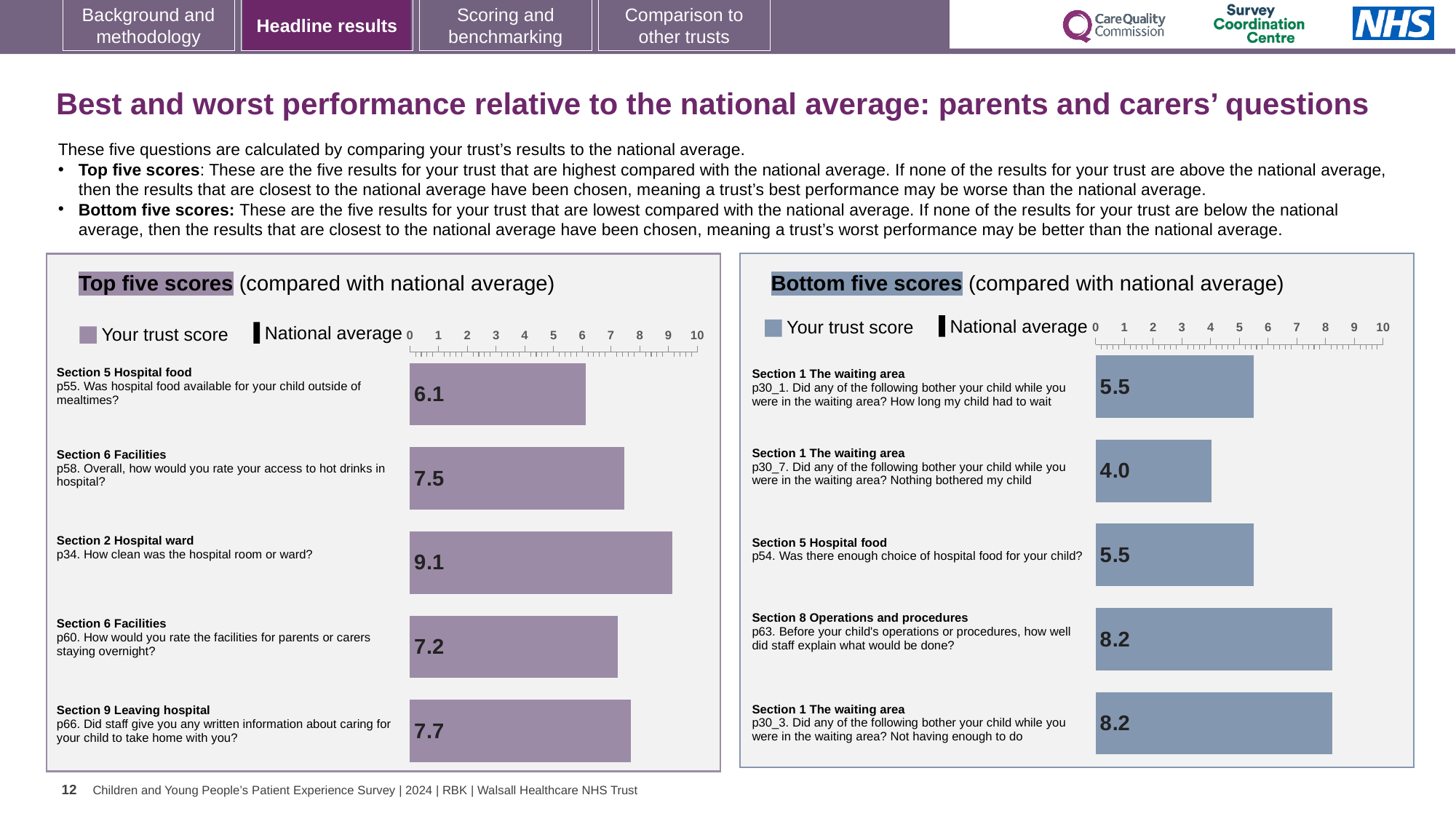
In the Top five scores chart, what is the trust score for p34. How clean was the hospital room or ward? 9.1 In the Top five scores chart, what is the trust score for p55. Was hospital food available for your child outside of mealtimes? 6.1 In the Bottom five scores chart, what is the trust score for p63. Before your child's operations or procedures, how well did staff explain what would be done? 8.2 In the Bottom five scores chart, which question has the lowest trust score? p30_7. Did any of the following bother your child while you were in the waiting area? Nothing bothered my child How many series does the legend of the Bottom five scores chart list? 2 How many questions are shown in the Bottom five scores chart? 5 In the Top five scores chart, which has the larger trust score: p66 (written information about caring for your child) or p58 (access to hot drinks)? p66 In the Bottom five scores chart, what is the trust score for p30_7. Nothing bothered my child? 4.0 In the Bottom five scores chart, what is the difference between the trust scores for p63 and p54? 2.7 What kind of chart is the Top five scores chart? Bar chart In the Top five scores chart, what is the difference between the trust scores for p58 (access to hot drinks) and p60 (facilities for parents or carers staying overnight)? 0.3 In the Top five scores chart, which question has the highest trust score? p34. How clean was the hospital room or ward?